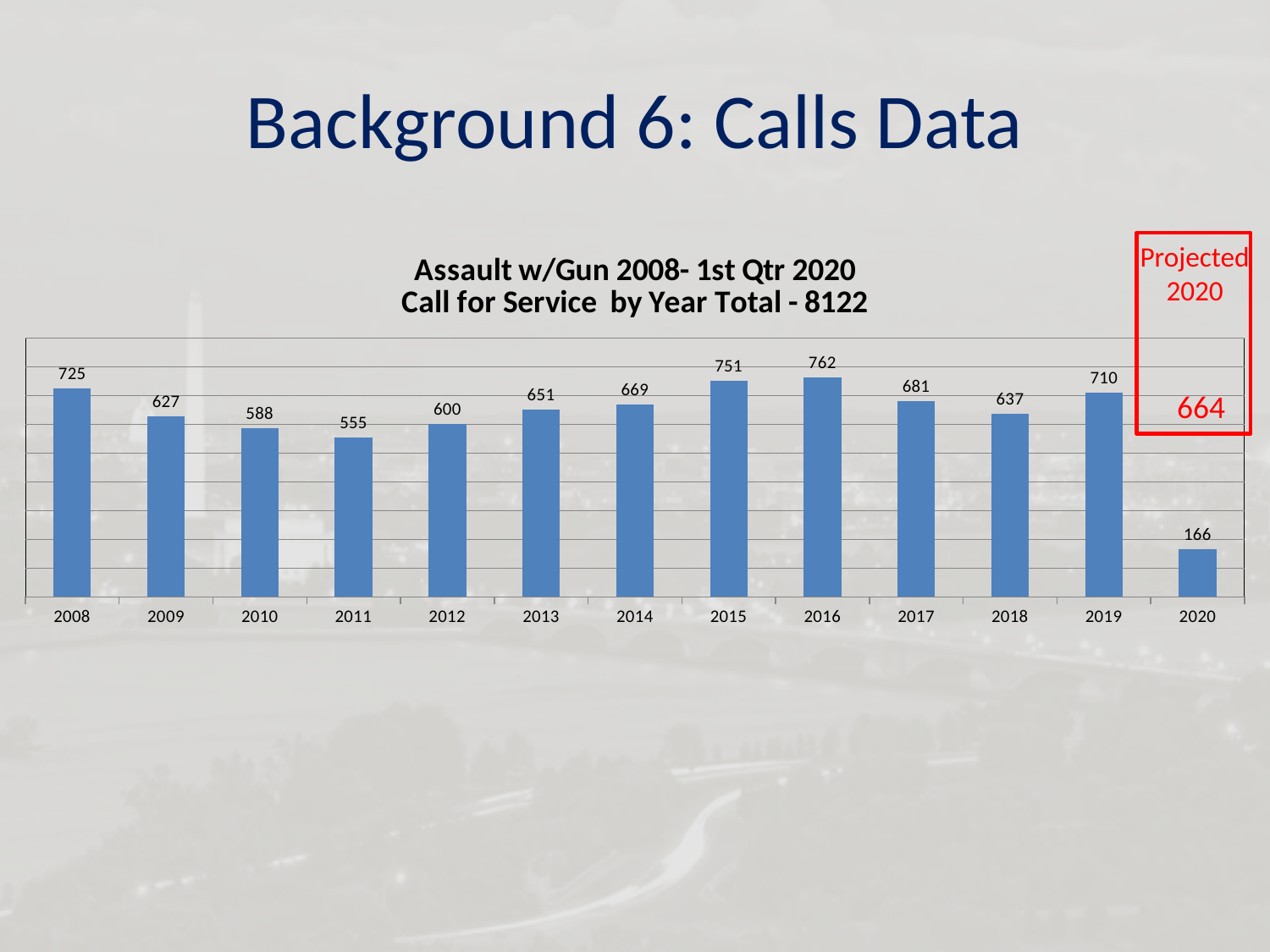
What is the total stated in the chart title? 8122 What is the difference between the values for 2016 and 2011? 207 What is the value for 2008? 725 What is the value for 2016? 762 What is the projected value for 2020 shown in the red box? 664 What kind of chart is this? Bar chart Which year has the lowest value? 2020 What is the value for 2020? 166 Which year has the highest value? 2016 How many years are shown on the x axis? 13 Which is larger, the value for 2017 or the value for 2018? 2017 Excluding 2020, which year has the lowest value? 2011